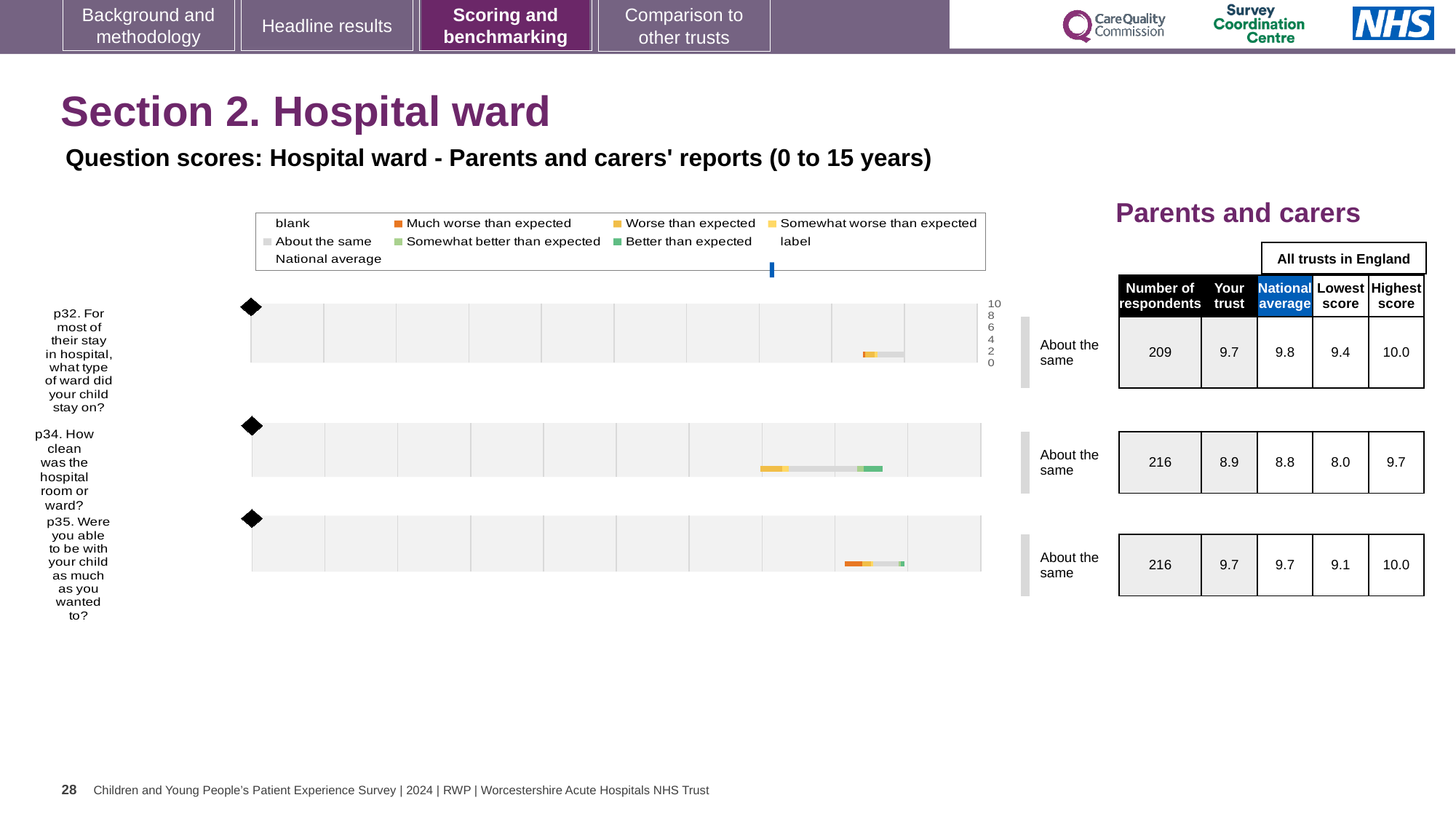
Which question has the lowest 'Your trust' score? p34. How clean was the hospital room or ward? What kind of chart is used to show the question scores? Bar chart What is the difference between the highest and lowest trust scores in England for p34? 1.7 For p34, is the 'Your trust' score higher or lower than the national average? Higher What is the highest score among all trusts in England for p35? 10.0 What benchmark category is shown for p32? About the same How many survey questions are plotted on the slide's charts? 3 What is the 'Your trust' score for p34 (How clean was the hospital room or ward?)? 8.9 What is the lowest score among all trusts in England for p32? 9.4 How many respondents answered p32 (For most of their stay in hospital, what type of ward did your child stay on?)? 209 What is the national average score for p35 (Were you able to be with your child as much as you wanted to?)? 9.7 Which colour in the legend represents 'Much worse than expected'? Orange